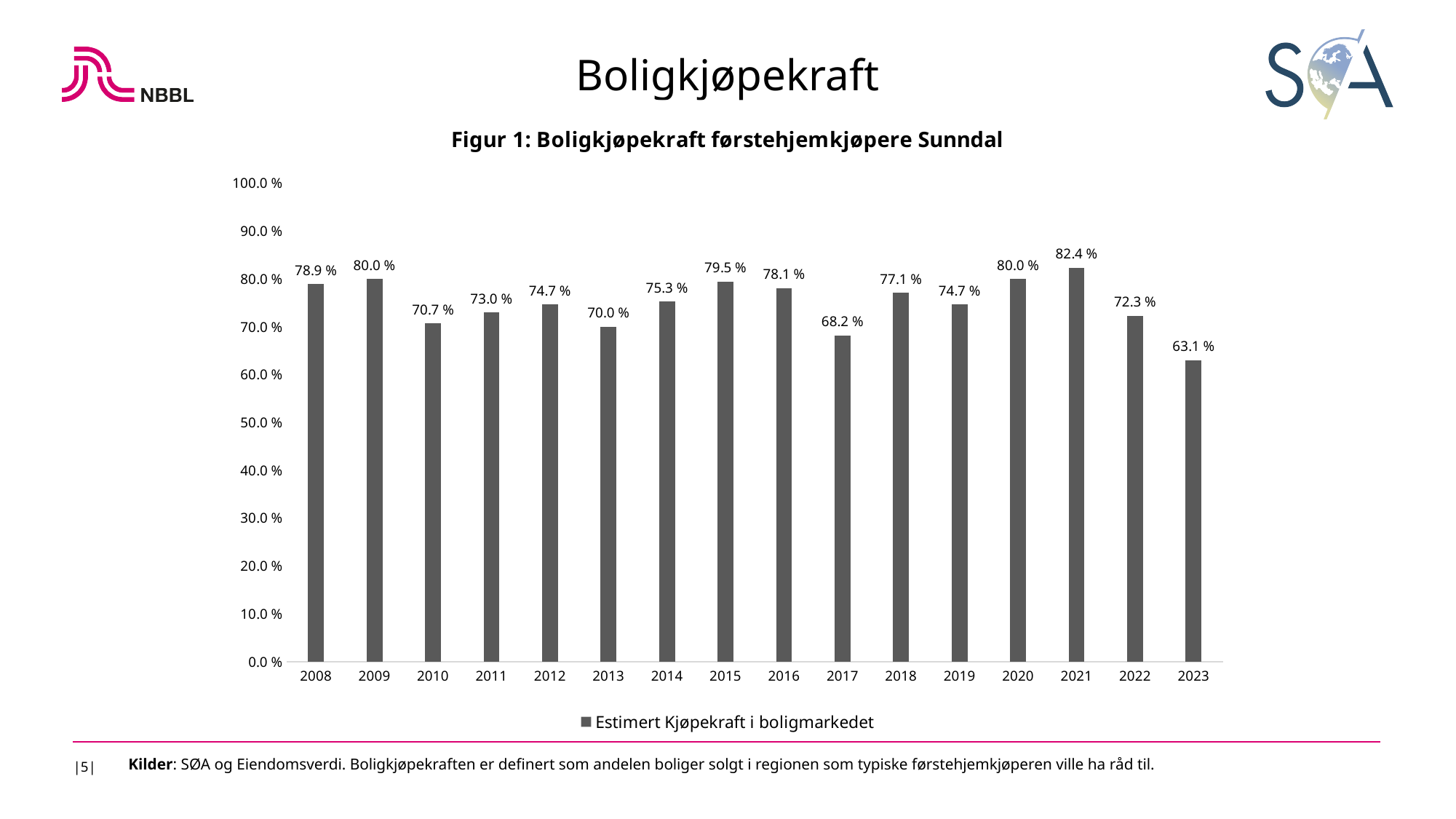
Is the value for 2013 greater or less than 60.0 %? greater Which year has the lowest value? 2023 Which year has the highest value? 2021 How many series does the legend list? 1 What is the legend entry for the series? Estimert Kjøpekraft i boligmarkedet What is the value for 2008? 78.9 % How many years are shown on the x axis? 16 What is the value for 2023? 63.1 % What kind of chart is shown? bar chart What is the value for 2017? 68.2 % What is the difference between the values for 2021 and 2023? 19.3 % Which is larger, the value for 2015 or the value for 2016? 2015